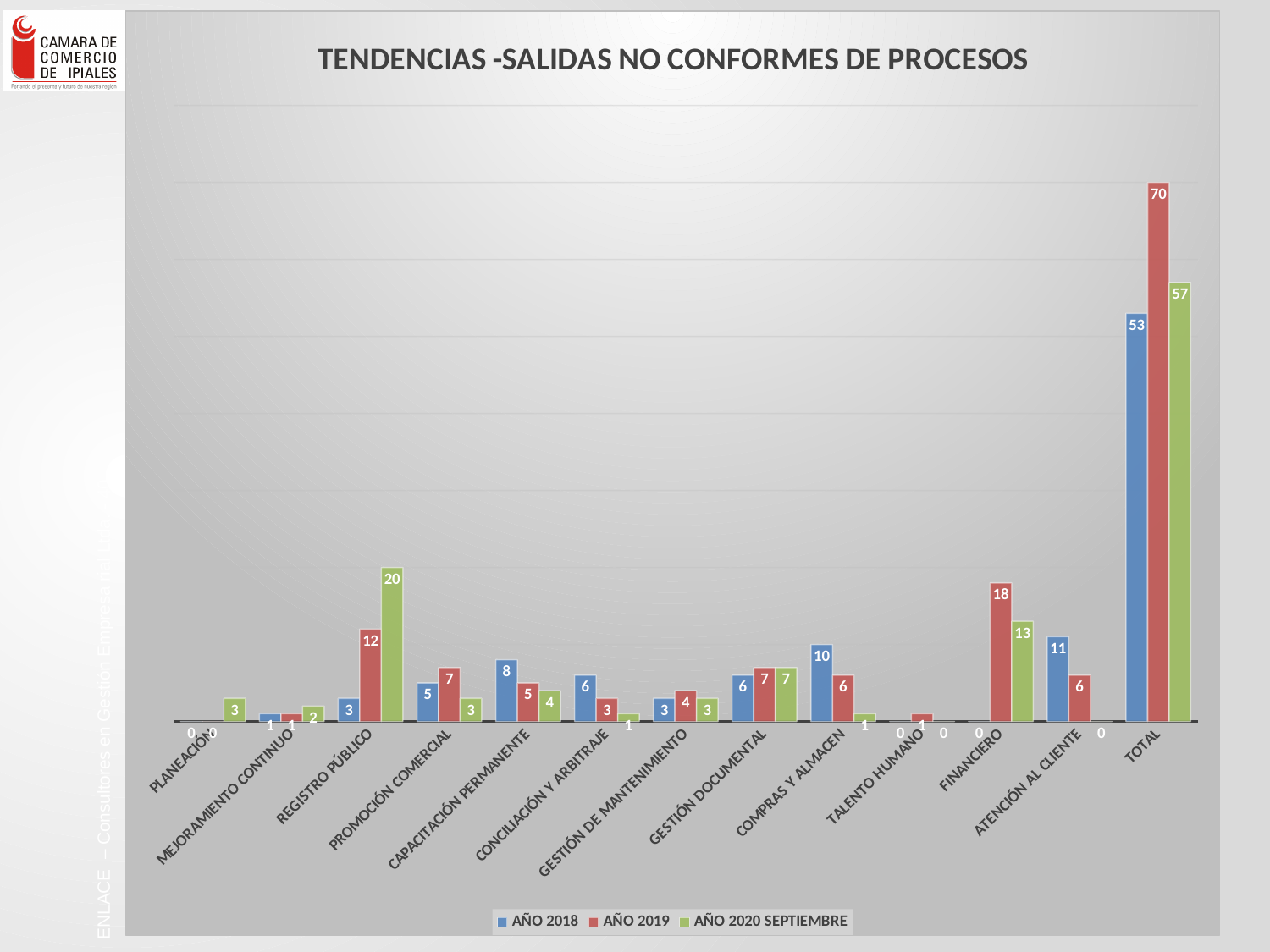
How many series does the legend list? 3 What is the title of the chart? TENDENCIAS -SALIDAS NO CONFORMES DE PROCESOS What type of chart is shown on the slide? bar chart What is the difference between the AÑO 2019 and AÑO 2018 values in the TOTAL category? 17 What is the value for AÑO 2019 in FINANCIERO? 18 What is the value for AÑO 2018 in ATENCIÓN AL CLIENTE? 11 Excluding TOTAL, which category has the highest AÑO 2018 value? ATENCIÓN AL CLIENTE What is the value for AÑO 2019 in the TOTAL category? 70 How many categories are shown on the x axis? 13 What is the value for AÑO 2018 in COMPRAS Y ALMACEN? 10 Which is larger in REGISTRO PÚBLICO: the AÑO 2019 value or the AÑO 2020 SEPTIEMBRE value? AÑO 2020 SEPTIEMBRE What is the value for AÑO 2020 SEPTIEMBRE in REGISTRO PÚBLICO? 20